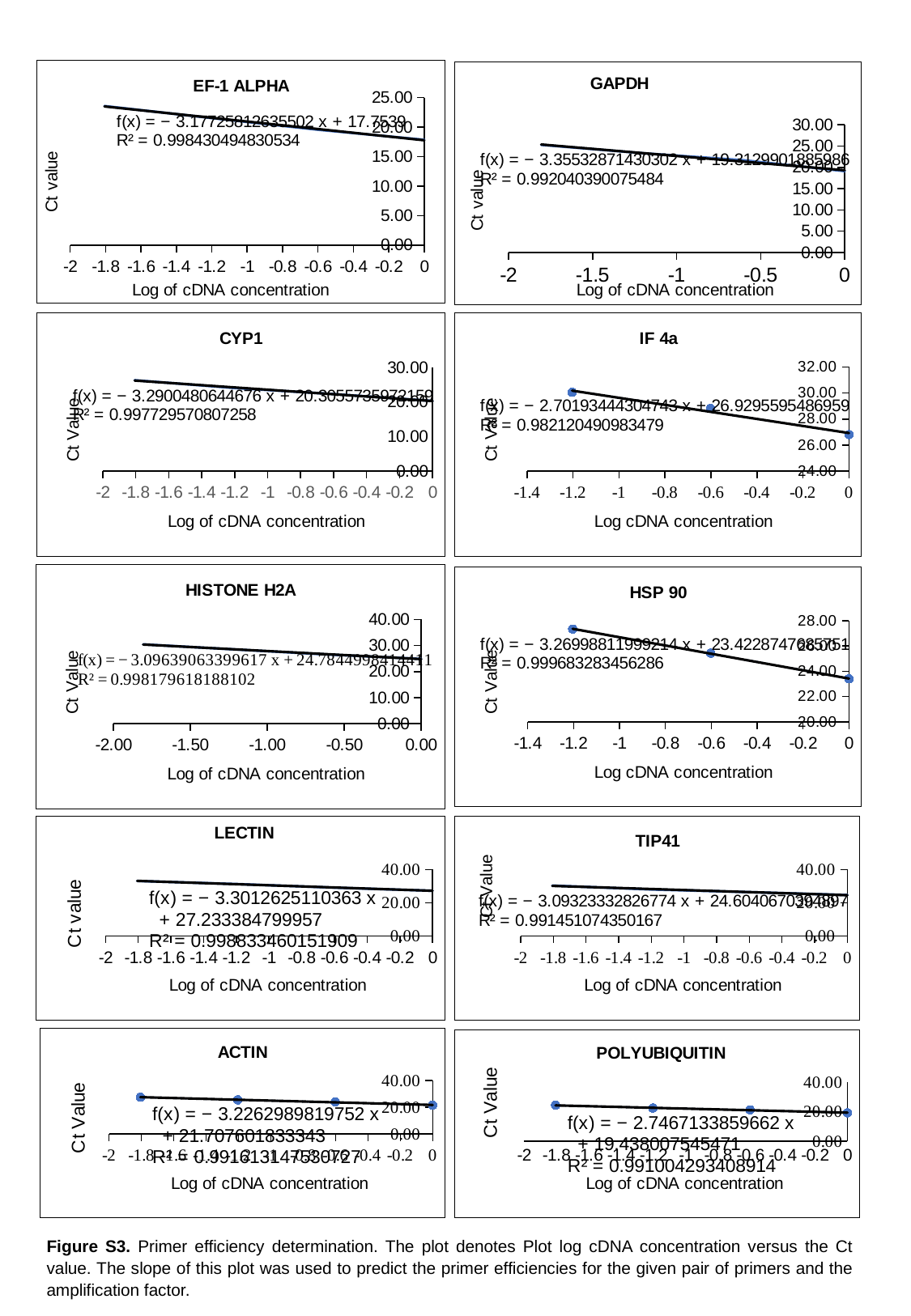
How many data points are plotted in the ACTIN chart? 4 What kind of chart is the IF 4a chart? scatter chart with a trendline In the IF 4a chart, which has the higher Ct value: the point at log concentration -1.2 or the point at 0? -1.2 In the HSP 90 chart, what is the R² value printed on the chart? 0.999683283456286 What is the title of the chart in the top-left position of the slide? EF-1 ALPHA How many data points are plotted in the HSP 90 chart? 3 In the HSP 90 chart, is the Ct value at log concentration 0 greater or less than 24.00? less In the POLYUBIQUITIN chart, what is the intercept of the fitted line shown in the equation? 19.4380075454711 In the GAPDH chart, what is the slope of the fitted line shown in the equation? −3.35532871430302 How many charts are shown on the slide? 10 In the IF 4a chart, does the Ct value rise or fall as the log of cDNA concentration increases? fall In the EF-1 ALPHA chart, what is the R² value printed on the chart? 0.998430494830534